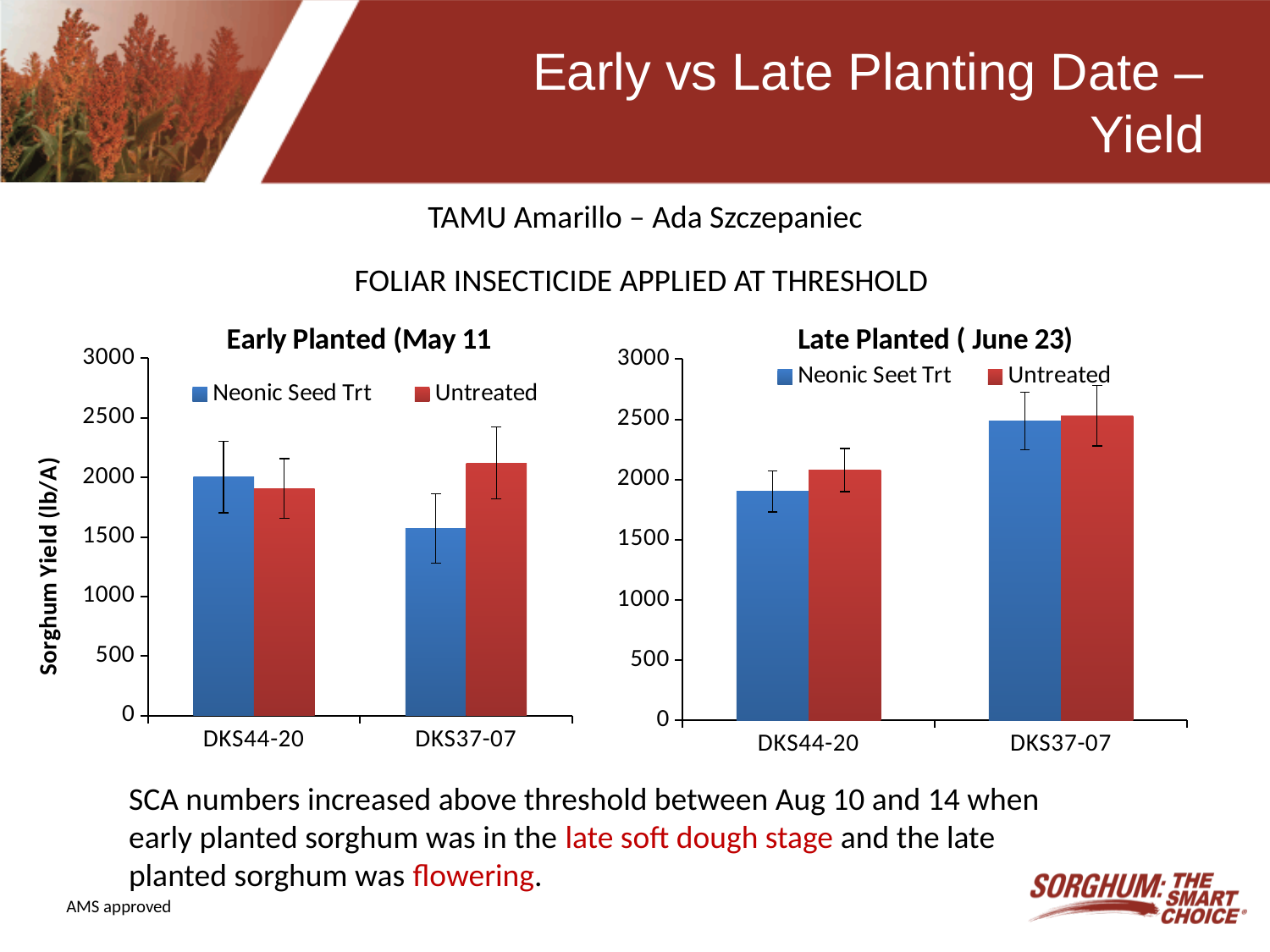
What colour represents the Untreated series in the Late Planted ( June 23) chart? red In the Early Planted (May 11 chart, is the Untreated value for DKS37-07 greater or less than 2000? greater In the Early Planted (May 11 chart, which is larger for DKS37-07: Neonic Seed Trt or Untreated? Untreated In the Late Planted ( June 23) chart, is the Neonic Seet Trt value for DKS37-07 greater or less than 2000? greater In the Early Planted (May 11 chart, is the Neonic Seed Trt value for DKS37-07 greater or less than 2000? less What is the y-axis label of the Early Planted (May 11 chart? Sorghum Yield (lb/A) How many series does the legend of the Late Planted ( June 23) chart list? 2 What type of chart is the Early Planted (May 11 chart? bar chart How many hybrid categories are shown on the x axis of the Early Planted (May 11 chart? 2 In the Early Planted (May 11 chart, which bar is the lowest? DKS37-07 Neonic Seed Trt In the Late Planted ( June 23) chart, which hybrid has the larger Neonic Seet Trt yield: DKS44-20 or DKS37-07? DKS37-07